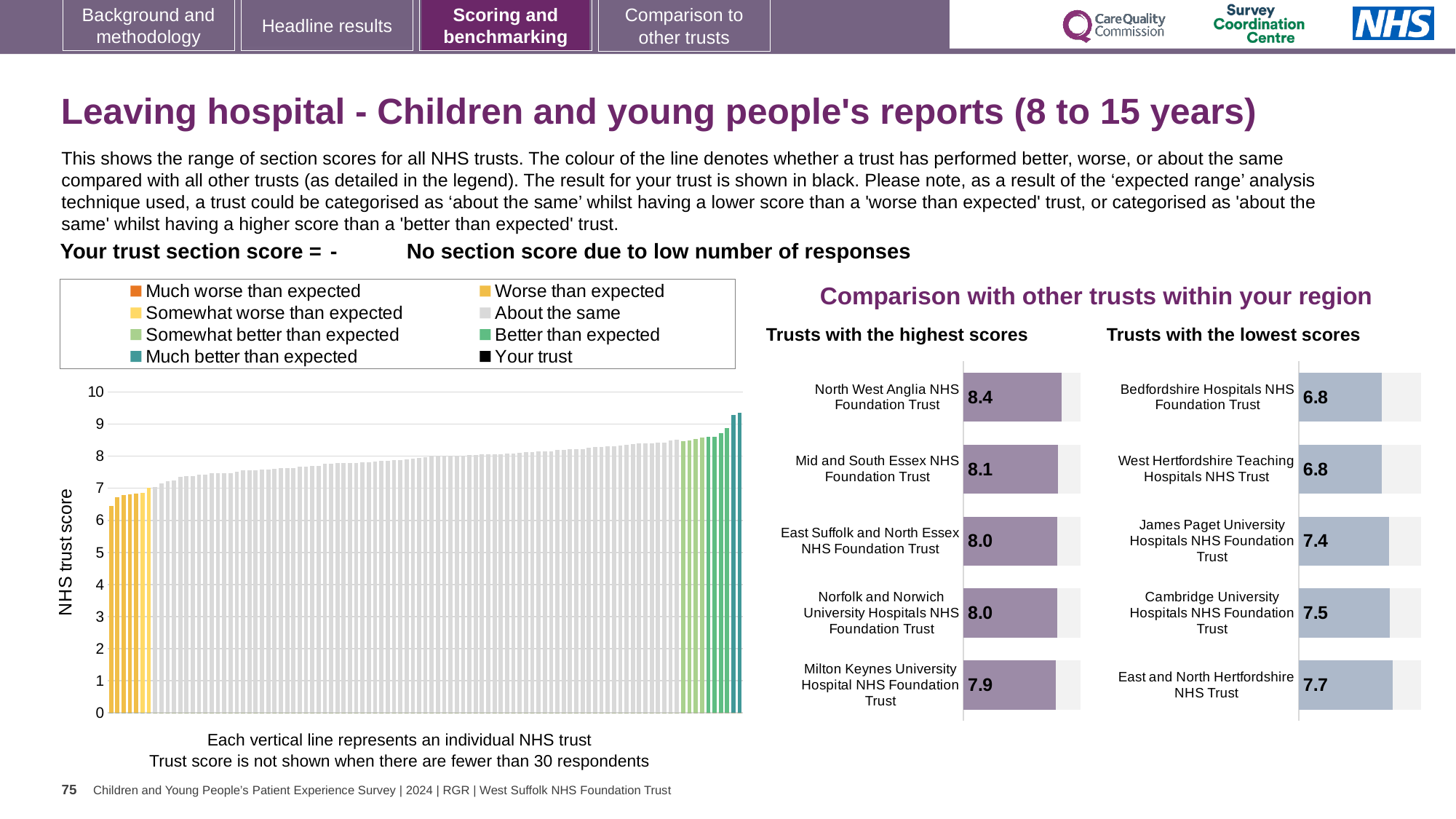
How many entries does the legend of the main chart on the left list? 8 In the main chart on the left showing NHS trust scores, do the values rise or fall from left to right? rise In the 'Trusts with the highest scores' chart, what is the score for North West Anglia NHS Foundation Trust? 8.4 How many trusts are listed in the 'Trusts with the highest scores' chart? 5 In the main chart on the left, is the value of the tallest bar greater or less than 9? greater In the 'Trusts with the highest scores' chart, which trust has the lowest score shown? Milton Keynes University Hospital NHS Foundation Trust In the 'Trusts with the lowest scores' chart, what is the difference between the scores of East and North Hertfordshire NHS Trust and Bedfordshire Hospitals NHS Foundation Trust? 0.9 What kind of chart is the main chart on the left showing NHS trust scores? bar chart In the 'Trusts with the lowest scores' chart, which has the larger score: Cambridge University Hospitals NHS Foundation Trust or James Paget University Hospitals NHS Foundation Trust? Cambridge University Hospitals NHS Foundation Trust In the 'Trusts with the lowest scores' chart, which trust has the highest score shown? East and North Hertfordshire NHS Trust In the 'Trusts with the highest scores' chart, what is the difference between the scores of North West Anglia NHS Foundation Trust and Milton Keynes University Hospital NHS Foundation Trust? 0.5 In the 'Trusts with the lowest scores' chart, what is the score for James Paget University Hospitals NHS Foundation Trust? 7.4